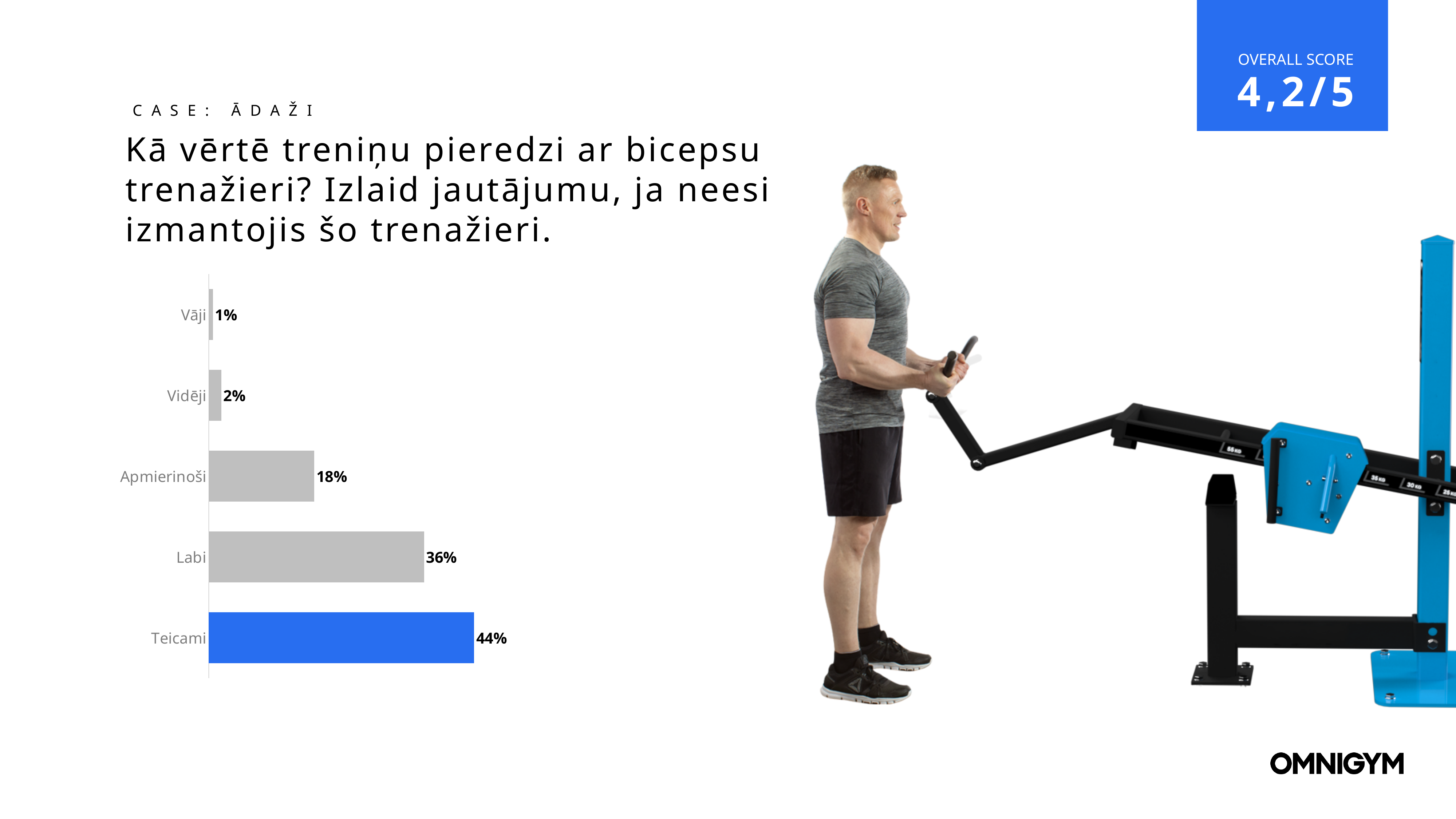
What is the value shown for the "Labi" category? 36% What is the difference between the values for "Teicami" and "Labi"? 8% What percentage of respondents rated the biceps machine training experience as "Teicami"? 44% Which is larger, the value for "Labi" or the value for "Apmierinoši"? Labi Which bar in the chart is coloured blue rather than grey? Teicami What is the difference between the values for "Apmierinoši" and "Vidēji"? 16% Which category has the highest value in the chart? Teicami How many categories are shown in the chart? 5 Which category has the lowest value in the chart? Vāji What is the value shown for the "Apmierinoši" category? 18% What kind of chart is shown on the slide? Bar chart What is the value shown for the "Vāji" category? 1%